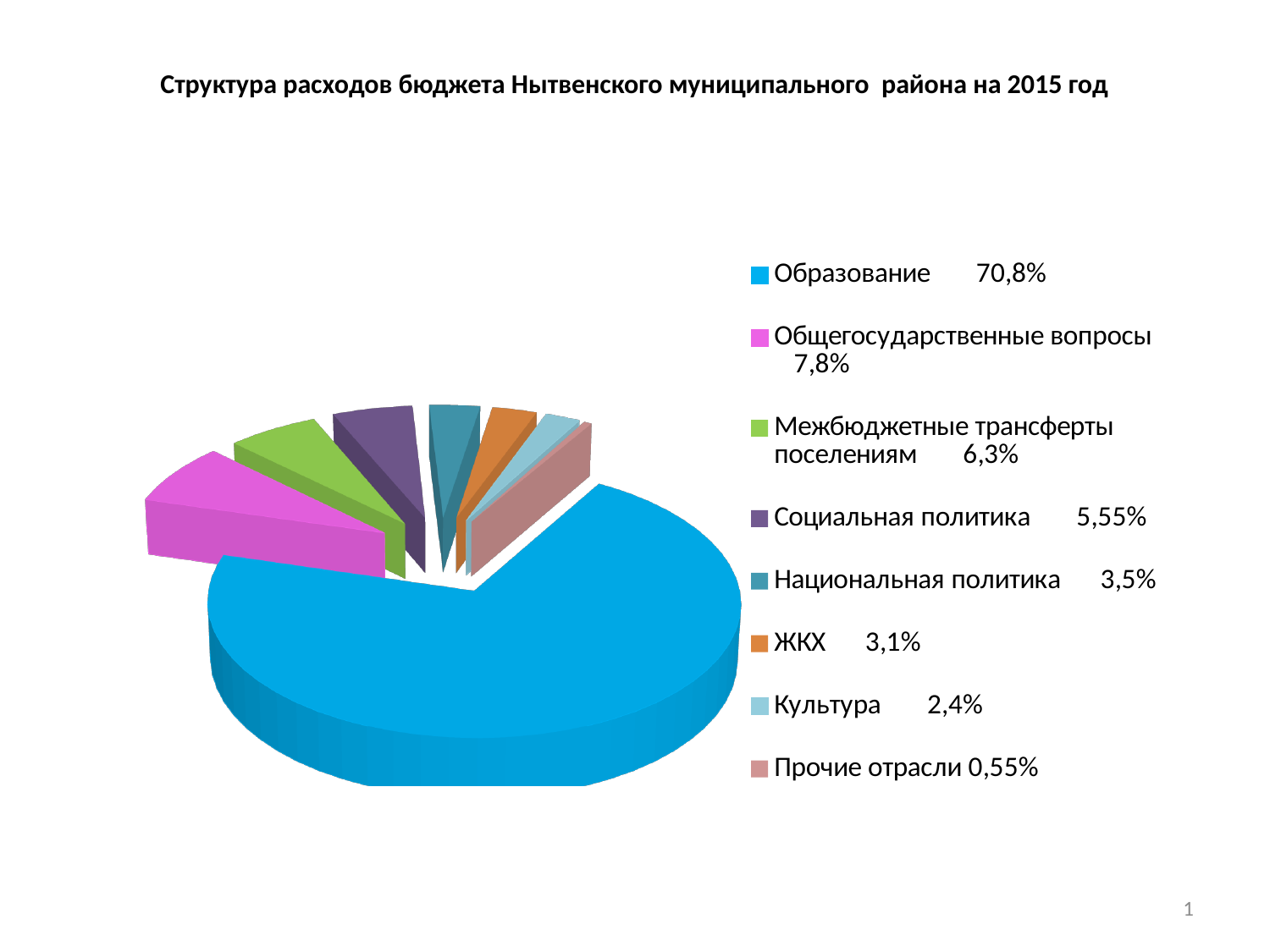
What is the title of the chart? Структура расходов бюджета Нытвенского муниципального района на 2015 год Which is larger, the share for Национальная политика or the share for ЖКХ? Национальная политика What percentage is listed for Прочие отрасли? 0,55% What percentage is shown for Межбюджетные трансферты поселениям? 6,3% What is the value for Социальная политика? 5,55% Which category has the smallest share of the pie? Прочие отрасли How many categories does the pie chart have? 8 Which category has the largest share of the pie? Образование What is the value shown for Общегосударственные вопросы? 7,8% What kind of chart is shown on the slide? pie chart What is the difference between the shares for Общегосударственные вопросы and Межбюджетные трансферты поселениям? 1,5% What share of the budget expenditure goes to Образование? 70,8%